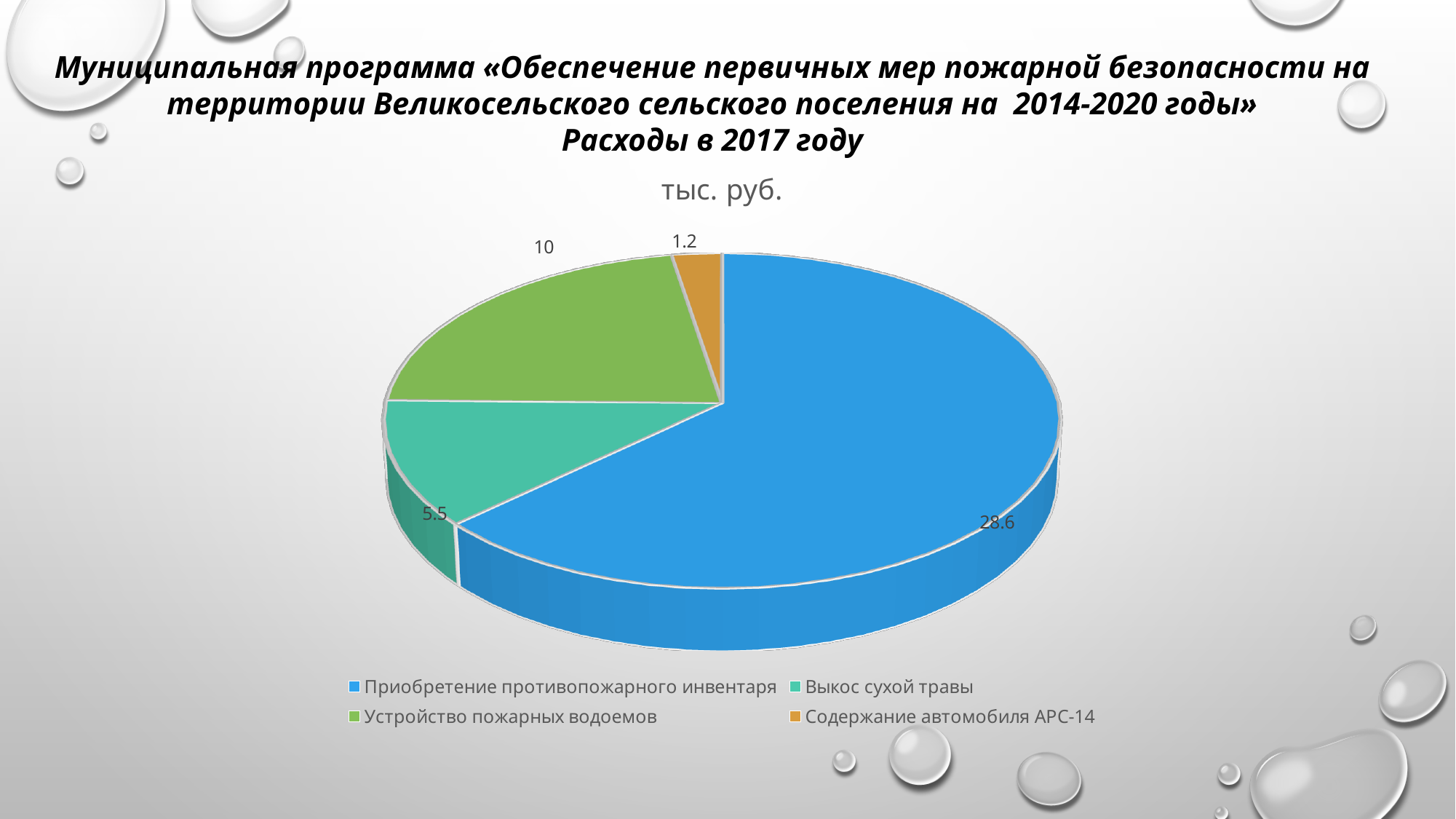
How many categories does the pie chart have? 4 What is the title of the chart? тыс. руб. What is the value for Приобретение противопожарного инвентаря? 28.6 What is the value for Устройство пожарных водоемов? 10 What is the value for Выкос сухой травы? 5.5 Which category has the largest slice of the pie? Приобретение противопожарного инвентаря What type of chart is shown on the slide? Pie chart Which is larger: the value for Выкос сухой травы or the value for Устройство пожарных водоемов? Устройство пожарных водоемов What is the difference between the values for Приобретение противопожарного инвентаря and Устройство пожарных водоемов? 18.6 Which category has the smallest slice of the pie? Содержание автомобиля АРС-14 What is the total of all slices in the pie chart? 45.3 What is the value for Содержание автомобиля АРС-14? 1.2